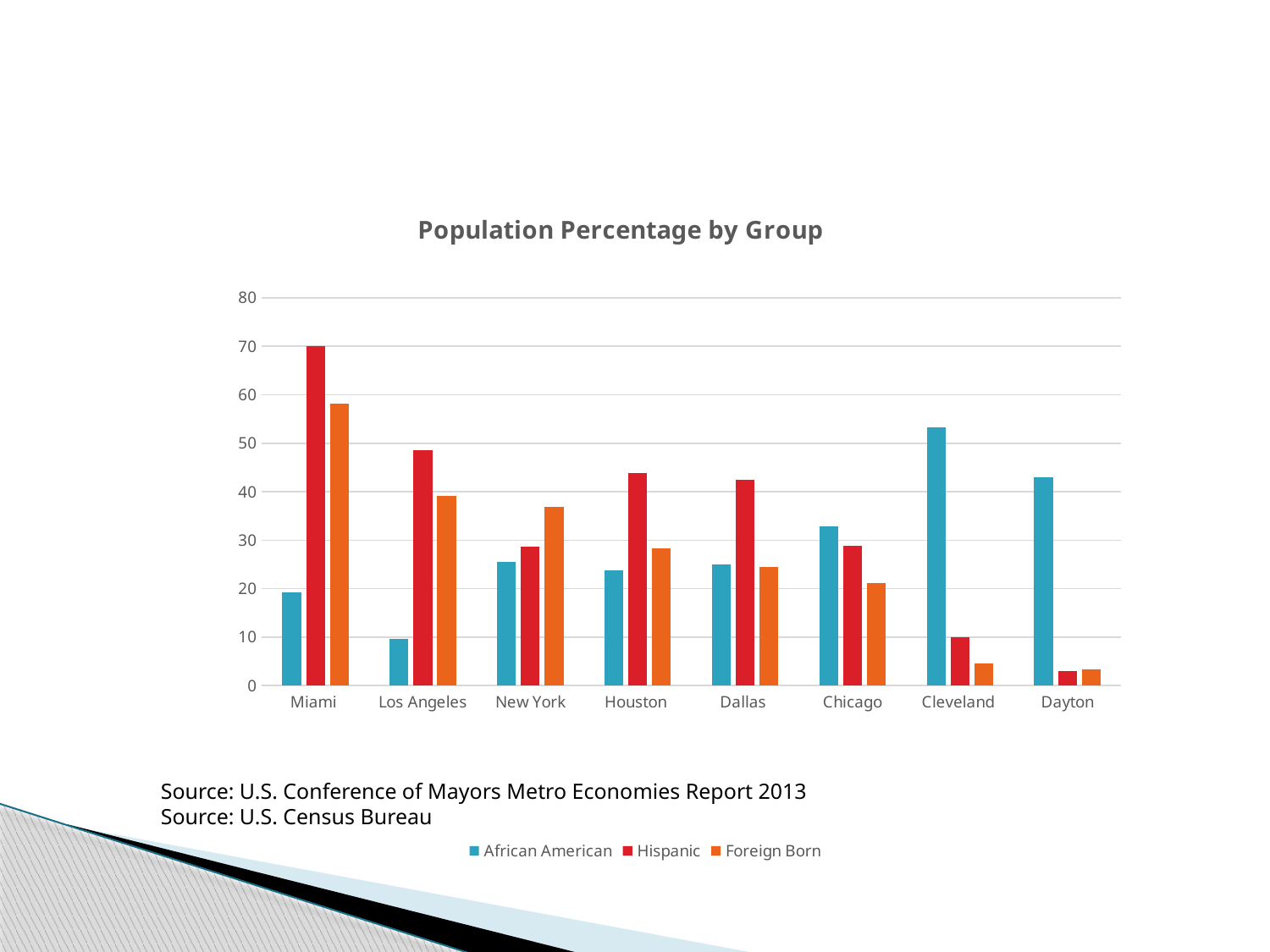
How many series does the legend list? 3 Which city has the highest African American percentage? Cleveland Which city has the lowest African American percentage? Los Angeles How many cities are shown on the x axis? 8 Is the Foreign Born value for Cleveland greater or less than 10? less What is the title of the chart? Population Percentage by Group Is the Foreign Born value for Miami greater or less than 50? greater In Houston, which is larger: the Hispanic value or the Foreign Born value? Hispanic Is the Hispanic value for Miami greater or less than 60? greater In Chicago, which is larger: the African American value or the Hispanic value? African American What kind of chart is shown on the slide? bar chart Which city has the highest Hispanic percentage? Miami